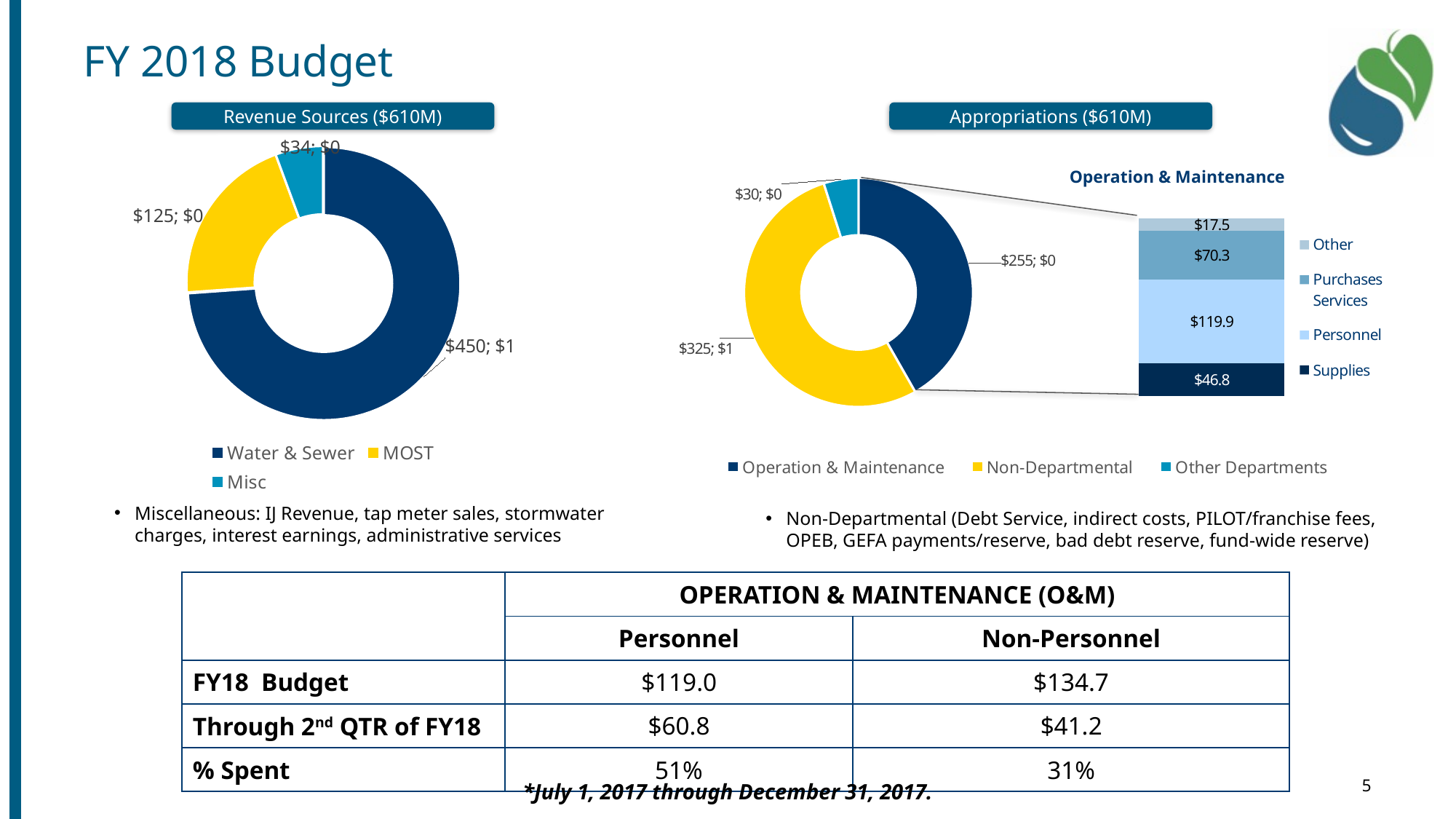
What kind of chart is the Revenue Sources ($610M) chart? donut (pie) chart In the Revenue Sources ($610M) chart, what colour represents MOST? yellow In the Revenue Sources ($610M) chart, which category is the largest? Water & Sewer How many categories does the legend of the Revenue Sources ($610M) chart list? 3 In the Revenue Sources ($610M) chart, what data label is shown for the Water & Sewer slice? $450; $1 In the Appropriations ($610M) chart, which category is the largest? Non-Departmental In the Operation & Maintenance breakdown bar of the Appropriations chart, what is the difference between Personnel and Purchases Services? $49.6 In the Appropriations ($610M) chart, what data label is shown for the Other Departments slice? $30; $0 In the Operation & Maintenance breakdown bar of the Appropriations chart, which component is the smallest? Other In the Operation & Maintenance breakdown bar of the Appropriations chart, what is the value for Personnel? $119.9 In the Revenue Sources ($610M) chart, which category is the smallest? Misc In the Operation & Maintenance breakdown bar of the Appropriations chart, which is larger: Supplies or Purchases Services? Purchases Services